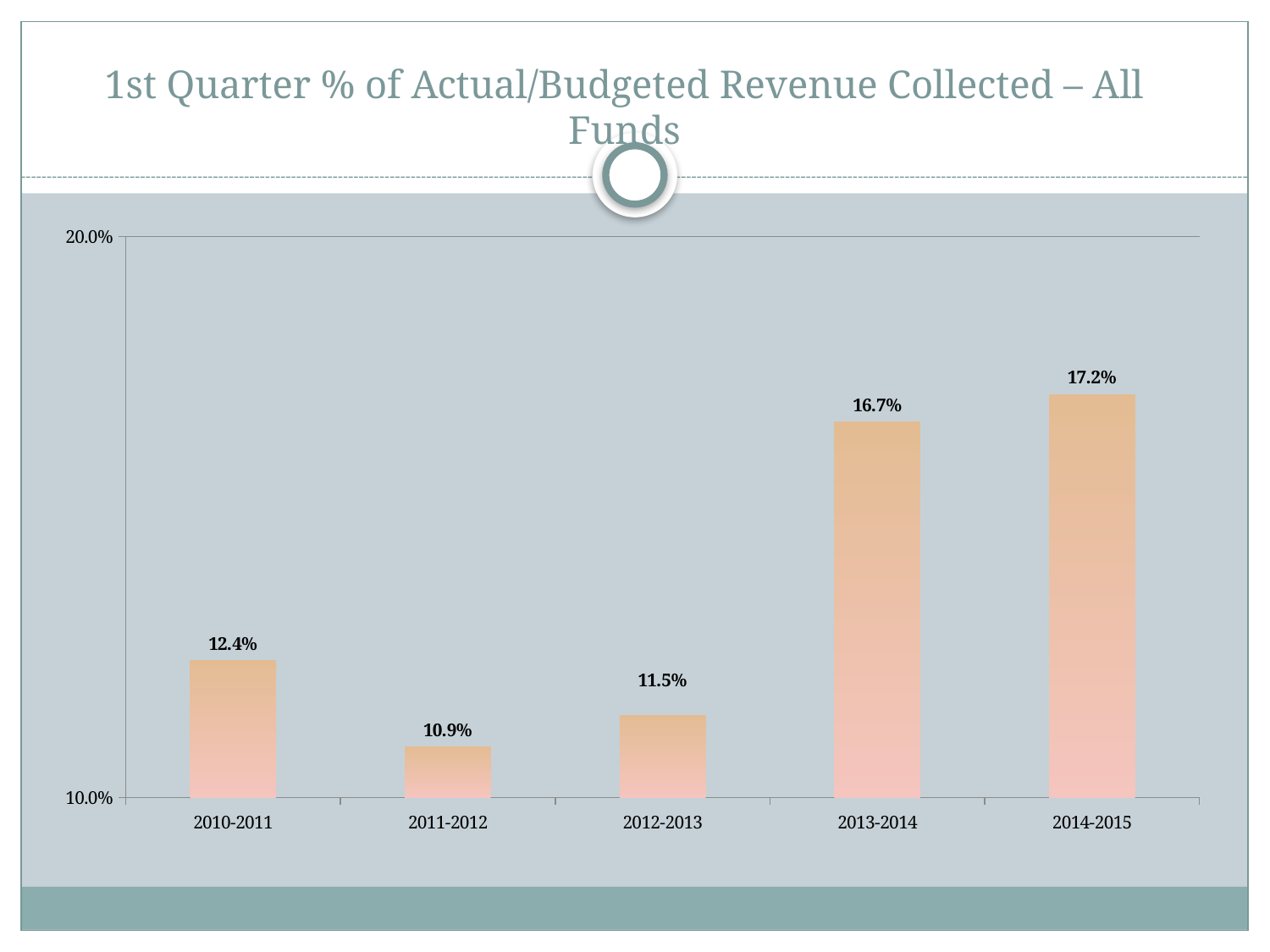
What is the value for 2013-2014? 16.7% What is the difference between the values for 2014-2015 and 2013-2014? 0.5% Which year has the lowest value? 2011-2012 What is the value for 2011-2012? 10.9% What is the title of the chart? 1st Quarter % of Actual/Budgeted Revenue Collected – All Funds How many years are shown on the chart? 5 Which year has the highest value? 2014-2015 What is the value for 2010-2011? 12.4% What kind of chart is this? bar chart Which is larger, the value for 2012-2013 or the value for 2010-2011? 2010-2011 Do the values rise or fall from 2011-2012 to 2014-2015? rise What is the difference between the values for 2010-2011 and 2011-2012? 1.5%